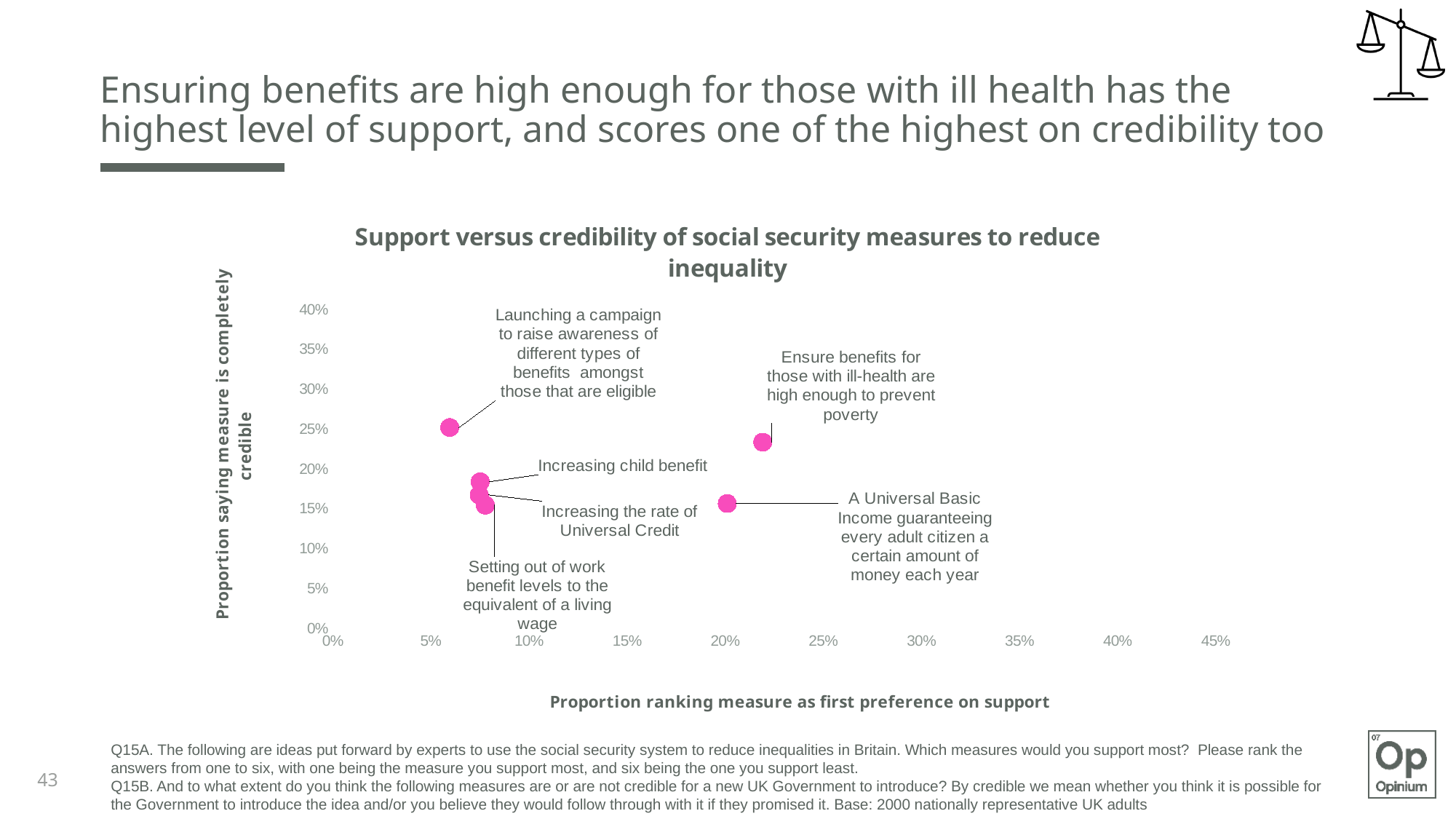
Is the proportion ranking 'Increasing child benefit' as first preference on support greater or less than 10%? less What kind of chart is shown on the slide? Scatter chart Which has a higher proportion saying it is completely credible: 'Ensure benefits for those with ill-health are high enough to prevent poverty' or 'A Universal Basic Income'? Ensure benefits for those with ill-health are high enough to prevent poverty What is the title of the chart? Support versus credibility of social security measures to reduce inequality How many social security measures are plotted on the chart? 6 Is the proportion ranking 'A Universal Basic Income' as first preference on support greater or less than 15%? greater Which measure has the highest proportion ranking it as first preference on support? Ensure benefits for those with ill-health are high enough to prevent poverty Is the proportion ranking 'Ensure benefits for those with ill-health are high enough to prevent poverty' as first preference on support greater or less than 20%? greater What does the horizontal axis of the chart measure? Proportion ranking measure as first preference on support Which has a higher proportion ranking it as first preference on support: 'Launching a campaign to raise awareness of different types of benefits' or 'A Universal Basic Income'? A Universal Basic Income